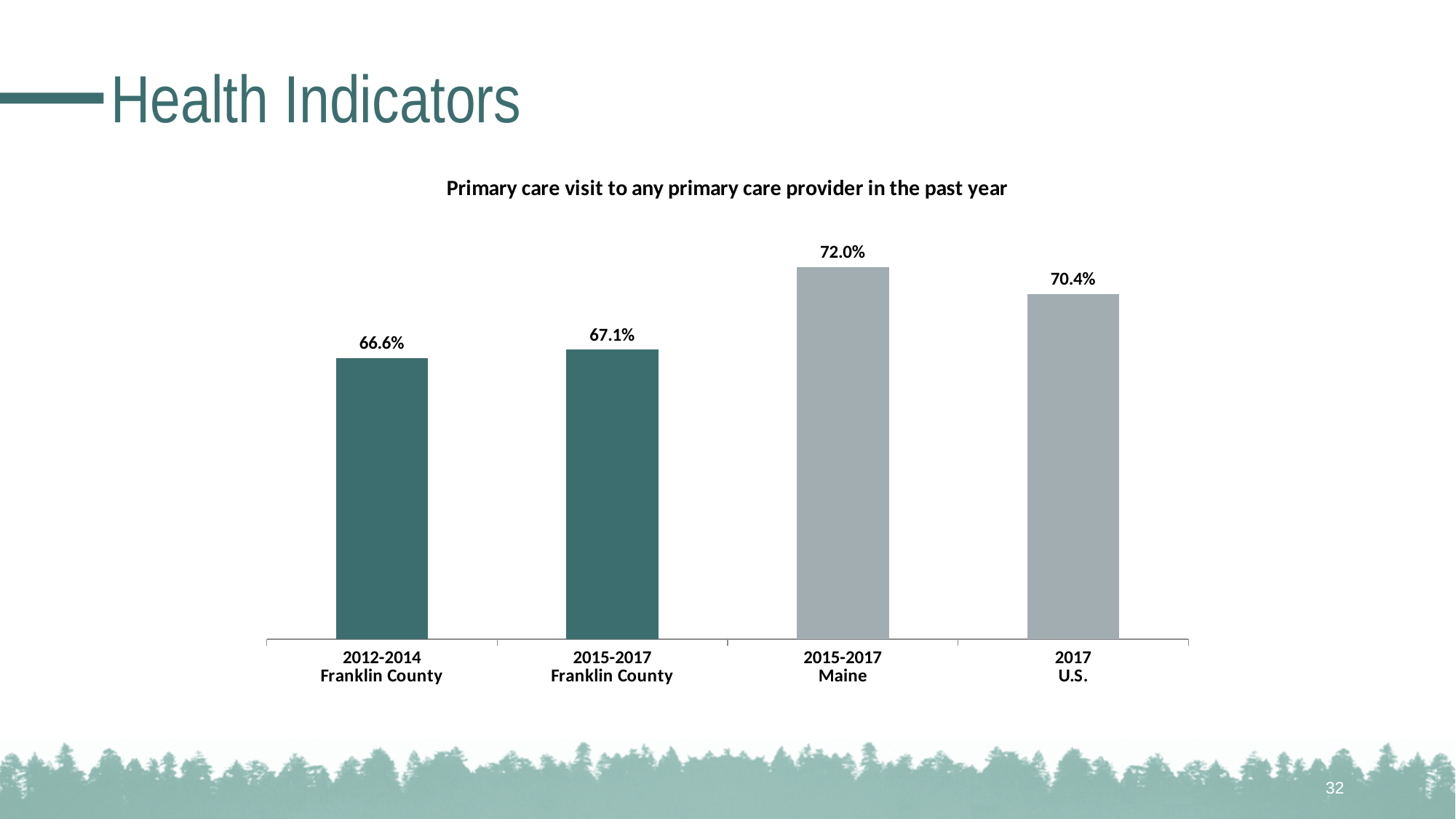
Which category has the highest value? 2015-2017 Maine What kind of chart is shown on the slide? Bar chart What is the value for 2015-2017 Franklin County? 67.1% What is the value for 2012-2014 Franklin County? 66.6% What is the value for 2017 U.S.? 70.4% What is the value for 2015-2017 Maine? 72.0% What is the title of the chart? Primary care visit to any primary care provider in the past year What is the difference between the 2015-2017 Maine value and the 2015-2017 Franklin County value? 4.9% Which is larger, the value for 2015-2017 Maine or the value for 2017 U.S.? 2015-2017 Maine What is the difference between the 2015-2017 Franklin County value and the 2012-2014 Franklin County value? 0.5% Which category has the lowest value? 2012-2014 Franklin County How many bars are shown in the chart? 4